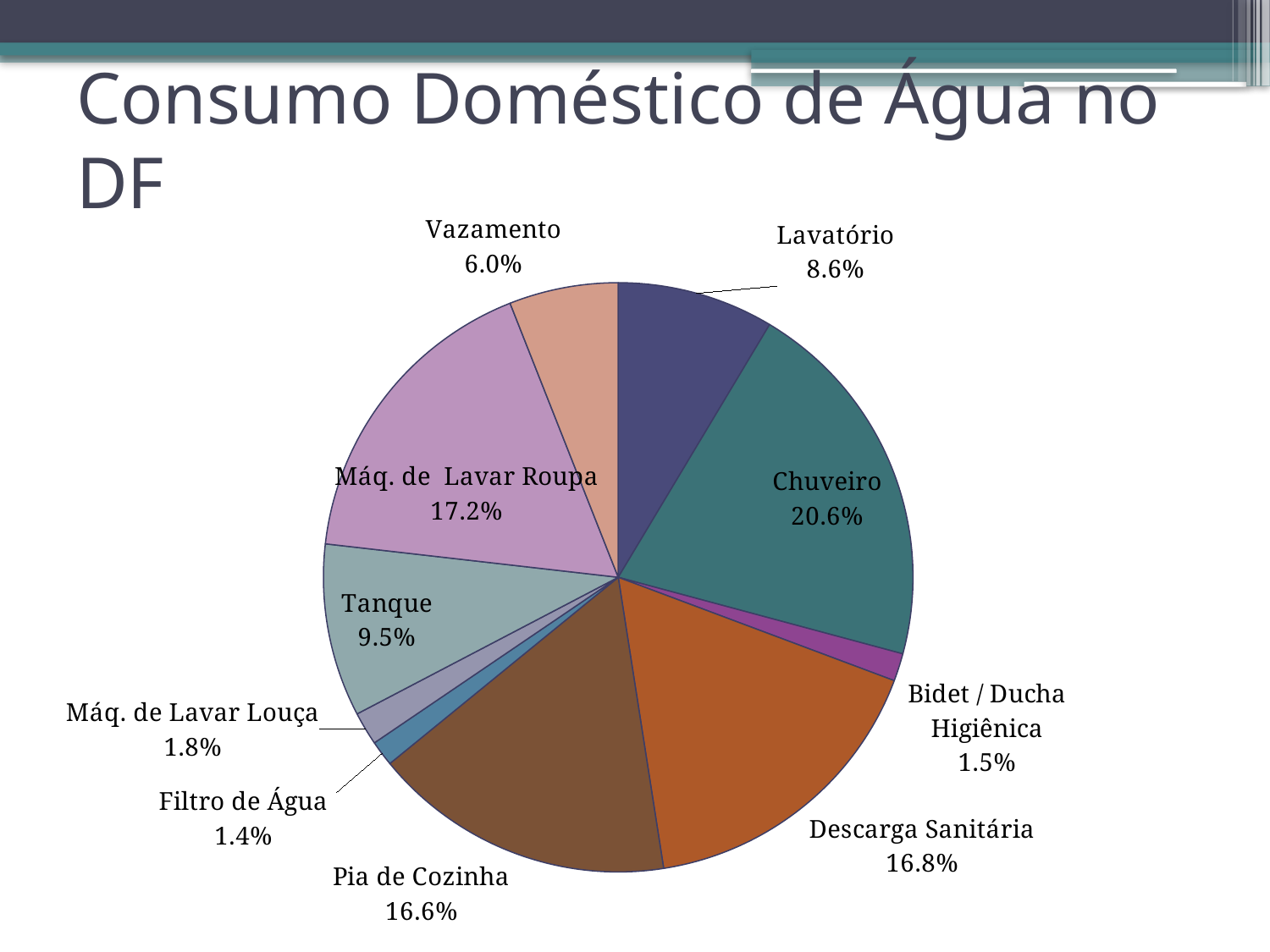
What percentage is shown for Vazamento? 6.0% Which category has the smallest share of the pie? Filtro de Água Which is larger, Descarga Sanitária or Pia de Cozinha? Descarga Sanitária What share of domestic water consumption is attributed to Chuveiro? 20.6% What percentage is shown for Máq. de Lavar Roupa? 17.2% What is the difference in percentage points between Chuveiro and Máq. de Lavar Roupa? 3.4 percentage points What is the difference in percentage points between Tanque and Lavatório? 0.9 percentage points What is the title of the slide? Consumo Doméstico de Água no DF What kind of chart is shown on the slide? Pie chart Which category has the largest share of the pie? Chuveiro What percentage is shown for Bidet / Ducha Higiênica? 1.5% How many slices does the pie chart have? 10